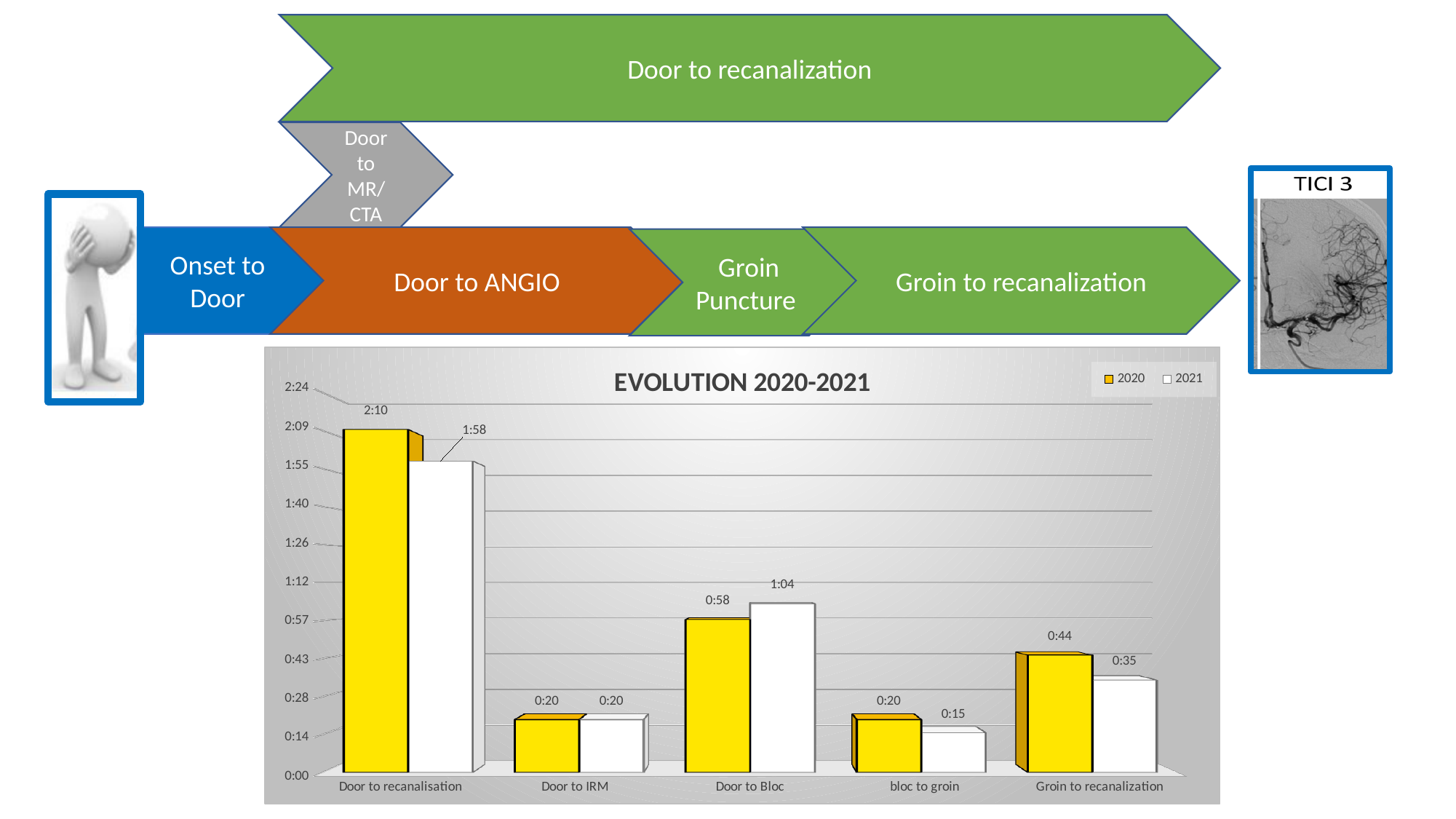
For Door to Bloc, which series has the larger value, 2020 or 2021? 2021 Which colour represents the 2020 series in the chart? yellow Which category has the highest 2020 value? Door to recanalisation What is the 2021 value for Groin to recanalization? 0:35 What is the title of the chart? EVOLUTION 2020-2021 Which category has the lowest 2021 value? bloc to groin How many categories are shown on the x axis of the chart? 5 How many series does the chart legend list? 2 What type of chart is shown on the slide? bar chart What is the 2021 value for Door to Bloc? 1:04 What is the difference between the 2020 and 2021 values for Door to recanalisation? 12 minutes What is the 2020 value for Door to recanalisation? 2:10